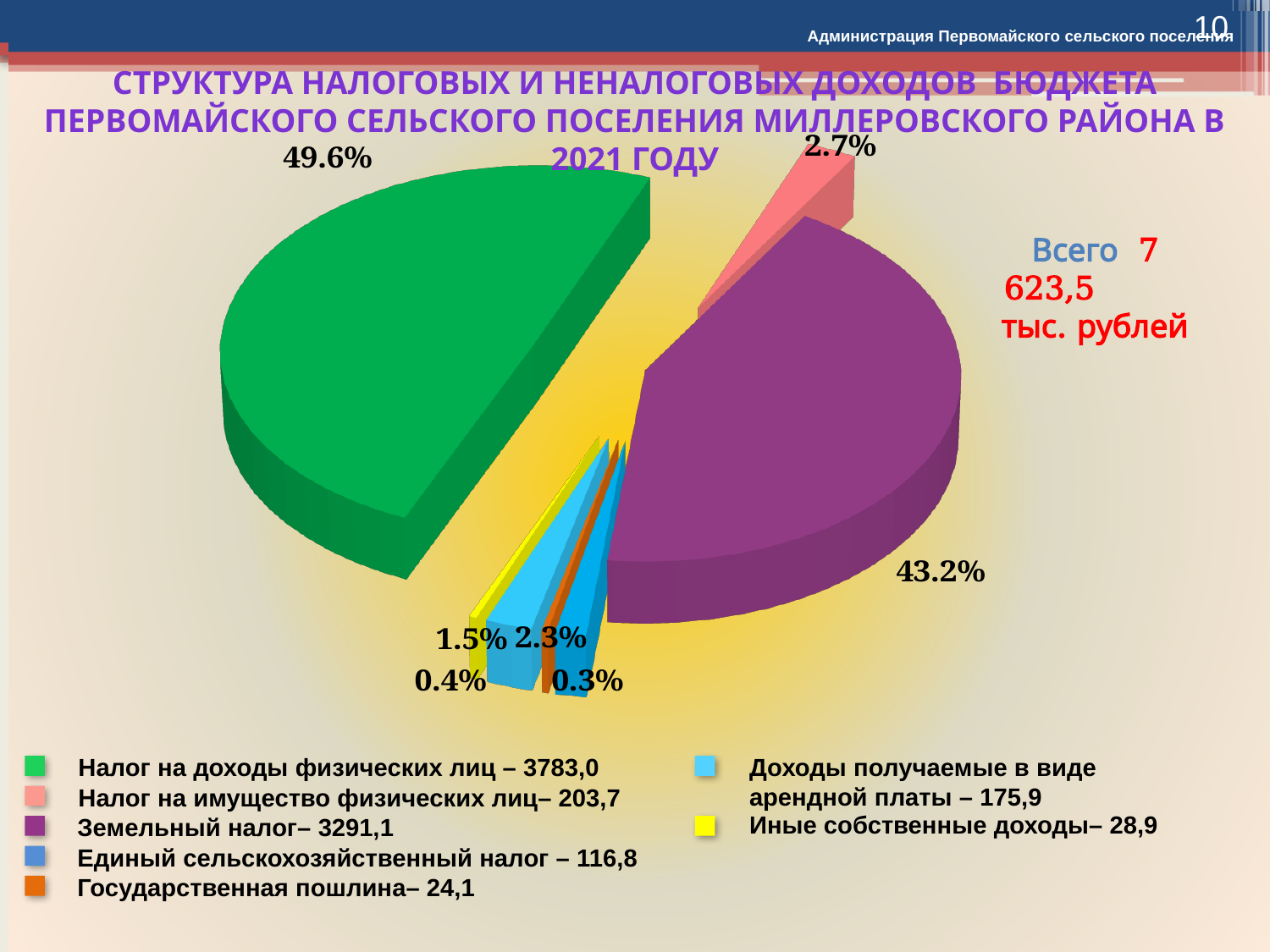
What share of the pie does Земельный налог (purple slice) have? 43.2% Which category has the smallest value according to the legend? Государственная пошлина Which is larger: Земельный налог or Налог на имущество физических лиц? Земельный налог Which category has the largest share of the pie? Налог на доходы физических лиц What value does the legend give for Доходы получаемые в виде арендной платы? 175,9 What is the difference between the values for Налог на доходы физических лиц and Земельный налог? 491,9 What share of the pie does Налог на имущество физических лиц (pink slice) have? 2.7% What total amount (Всего) is stated next to the pie chart? 7 623,5 тыс. рублей How many categories does the pie chart's legend list? 7 What value does the legend give for Земельный налог? 3291,1 What share of the pie does Налог на доходы физических лиц (green slice) have? 49.6% What kind of chart is shown on the slide? Pie chart